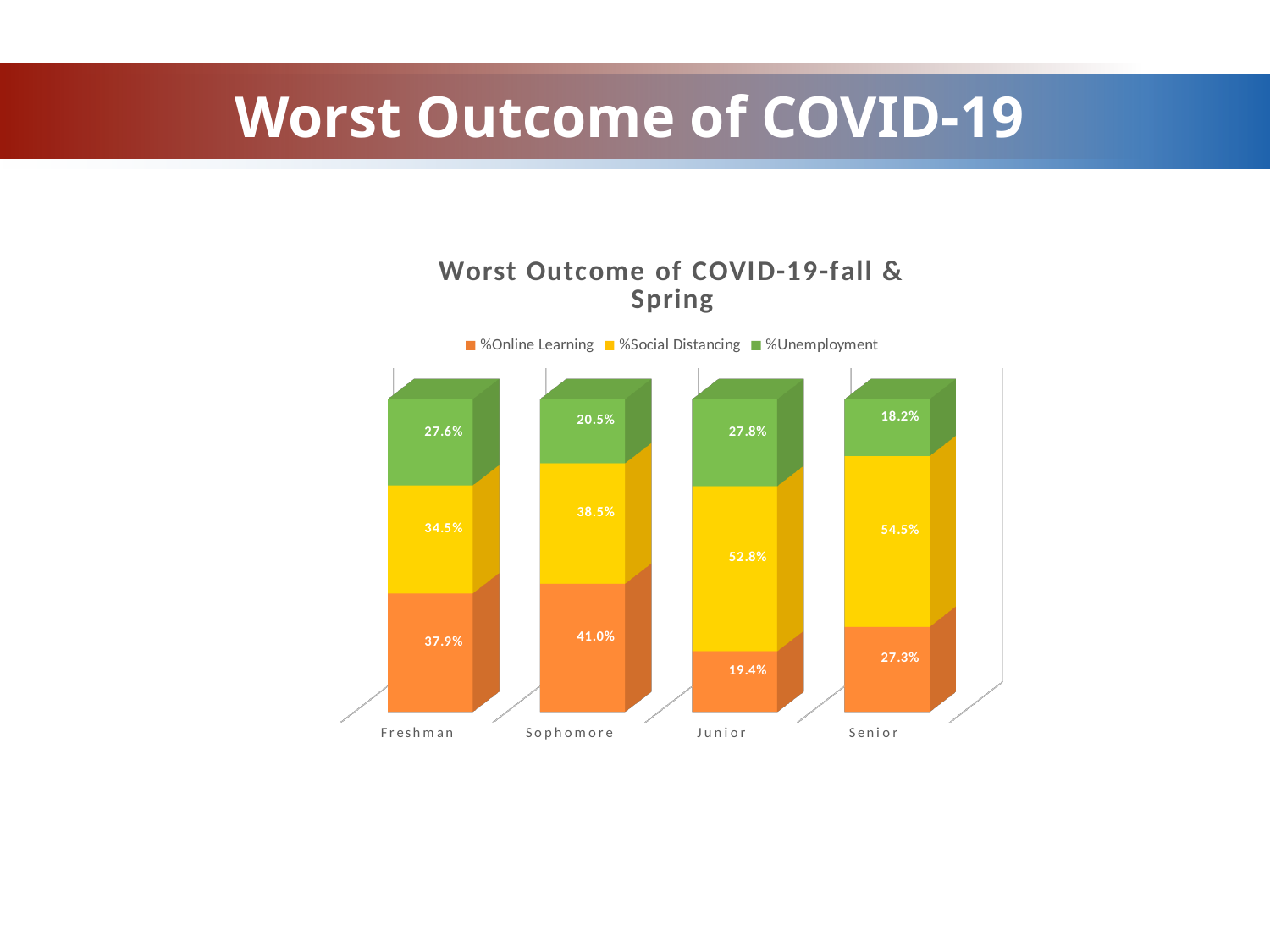
What is the %Unemployment value for Junior? 27.8% Which is larger, the %Unemployment value for Freshman or for Senior? Freshman How many series does the legend list? 3 What is the %Social Distancing value for Senior? 54.5% Which category has the highest %Social Distancing value? Senior How many categories are shown on the x axis? 4 What kind of chart is shown on the slide? Stacked bar chart What is the title of the chart? Worst Outcome of COVID-19-fall & Spring What is the total of the stacked bar for Junior? 100.0% What is the difference between the %Online Learning values for Sophomore and Junior? 21.6% Which category has the lowest %Online Learning value? Junior What is the %Online Learning value for Sophomore? 41.0%